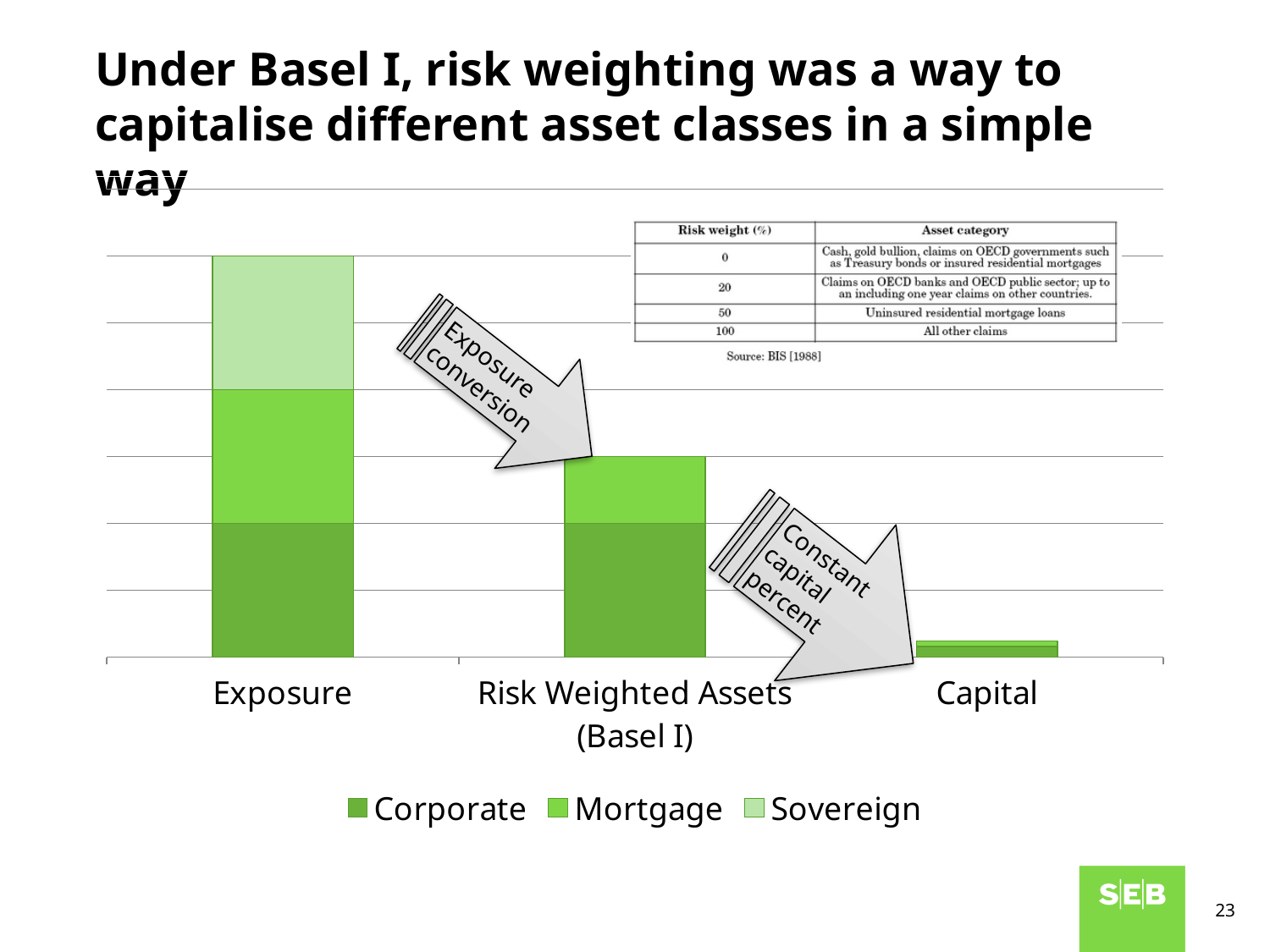
Which stacked bar is taller, Risk Weighted Assets (Basel I) or Capital? Risk Weighted Assets (Basel I) Which category has the tallest stacked bar? Exposure Which stacked bar is taller, Exposure or Risk Weighted Assets (Basel I)? Exposure Which series is at the bottom of each stacked bar? Corporate How many categories are shown on the x axis of the chart? 3 Do the bar totals rise or fall from left to right along the x axis? Fall Which category has the shortest stacked bar? Capital Which series appears in the Exposure bar but not in the Risk Weighted Assets (Basel I) bar? Sovereign How many series does the chart legend list? 3 What kind of chart is shown on the slide? Stacked bar chart